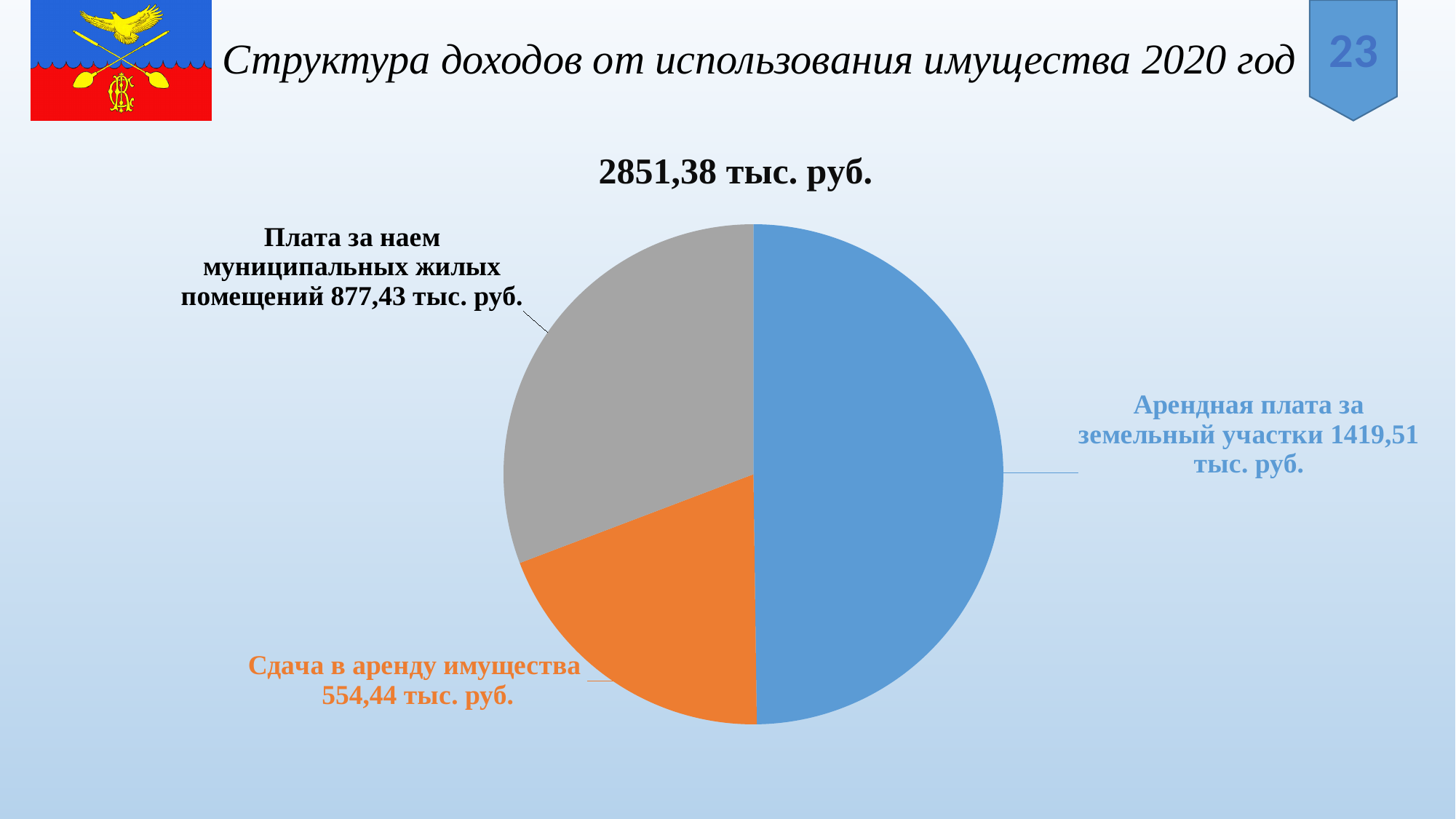
Which category has the largest slice of the pie? Арендная плата за земельный участки What kind of chart is shown on the slide? Pie chart What colour is the slice for Сдача в аренду имущества? Orange What is the difference between Плата за наем муниципальных жилых помещений and Сдача в аренду имущества? 322,99 тыс. руб. What is the value for Сдача в аренду имущества? 554,44 тыс. руб. Which category has the smallest slice of the pie? Сдача в аренду имущества How many slices does the pie chart have? 3 What is the value for Плата за наем муниципальных жилых помещений? 877,43 тыс. руб. Which is larger: Плата за наем муниципальных жилых помещений or Сдача в аренду имущества? Плата за наем муниципальных жилых помещений What is the difference between Арендная плата за земельный участки and Плата за наем муниципальных жилых помещений? 542,08 тыс. руб. What is the value for Арендная плата за земельный участки? 1419,51 тыс. руб. What is the total of all slices shown above the pie chart? 2851,38 тыс. руб.